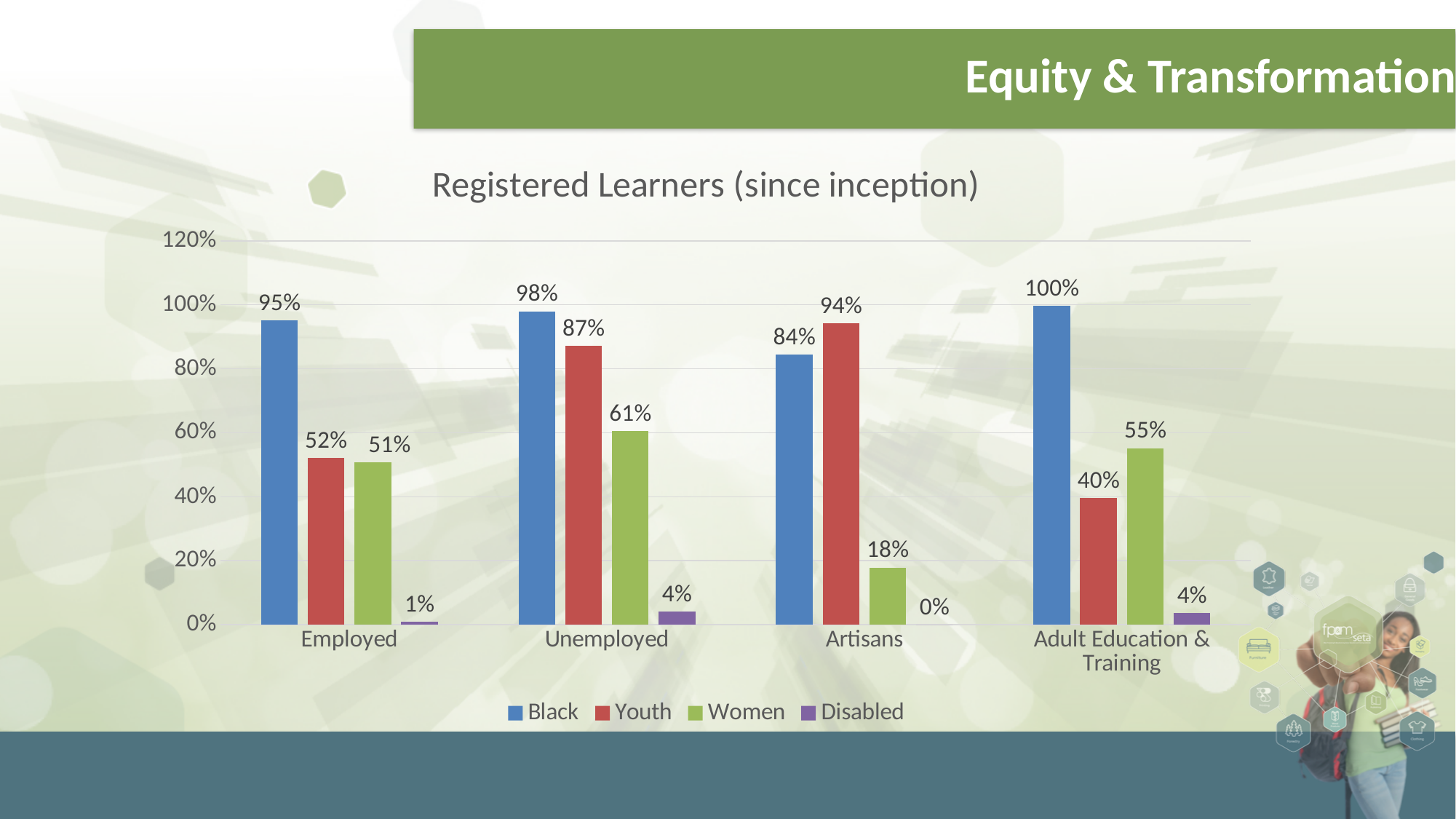
Which is larger in the Artisans category, Black or Youth? Youth What is the value for Women in the Unemployed category? 61% How many series does the legend list? 4 What is the difference between the Youth and Women values in the Adult Education & Training category? 15% What is the value for Youth in the Artisans category? 94% What kind of chart is shown on the slide? Bar chart Which category has the highest value for Black? Adult Education & Training Which category has the lowest value for Women? Artisans How many categories are shown on the x axis? 4 What is the value for Black in the Employed category? 95% What is the title of the chart? Registered Learners (since inception) What is the value for Disabled in the Adult Education & Training category? 4%